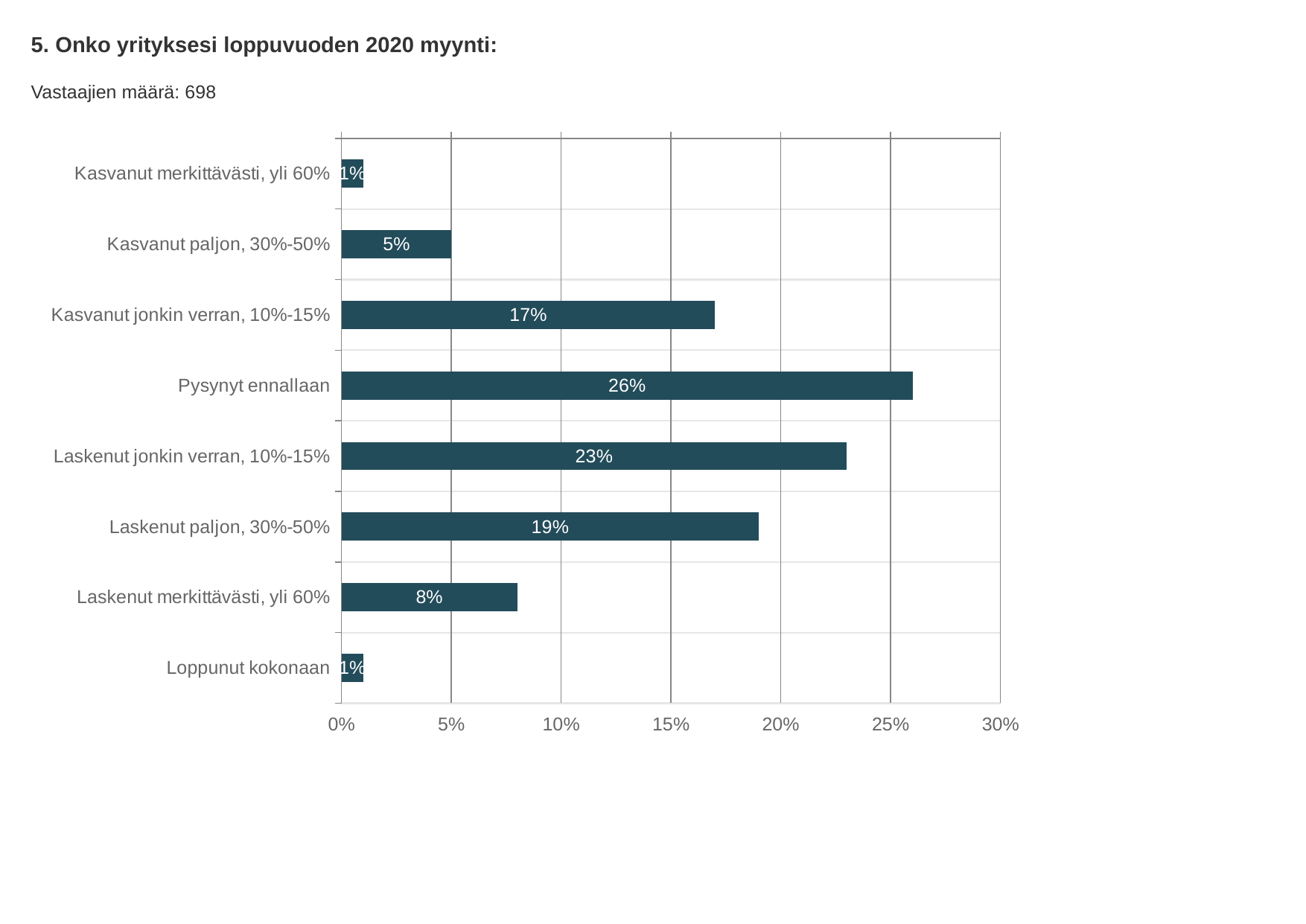
What is the difference between "Laskenut paljon, 30%-50%" and "Laskenut merkittävästi, yli 60%"? 11% What kind of chart is shown on the slide? bar chart Which is larger, "Kasvanut paljon, 30%-50%" or "Laskenut merkittävästi, yli 60%"? Laskenut merkittävästi, yli 60% Which category has the highest value? Pysynyt ennallaan What is the value for "Kasvanut jonkin verran, 10%-15%"? 17% Is the value for "Laskenut jonkin verran, 10%-15%" greater or less than 20%? greater What is the difference between "Pysynyt ennallaan" and "Laskenut jonkin verran, 10%-15%"? 3% What is the title of the chart? 5. Onko yrityksesi loppuvuoden 2020 myynti: What is the value for "Laskenut paljon, 30%-50%"? 19% What is the number of respondents (Vastaajien määrä) shown on the slide? 698 What is the value for "Pysynyt ennallaan"? 26% How many categories are shown in the chart? 8